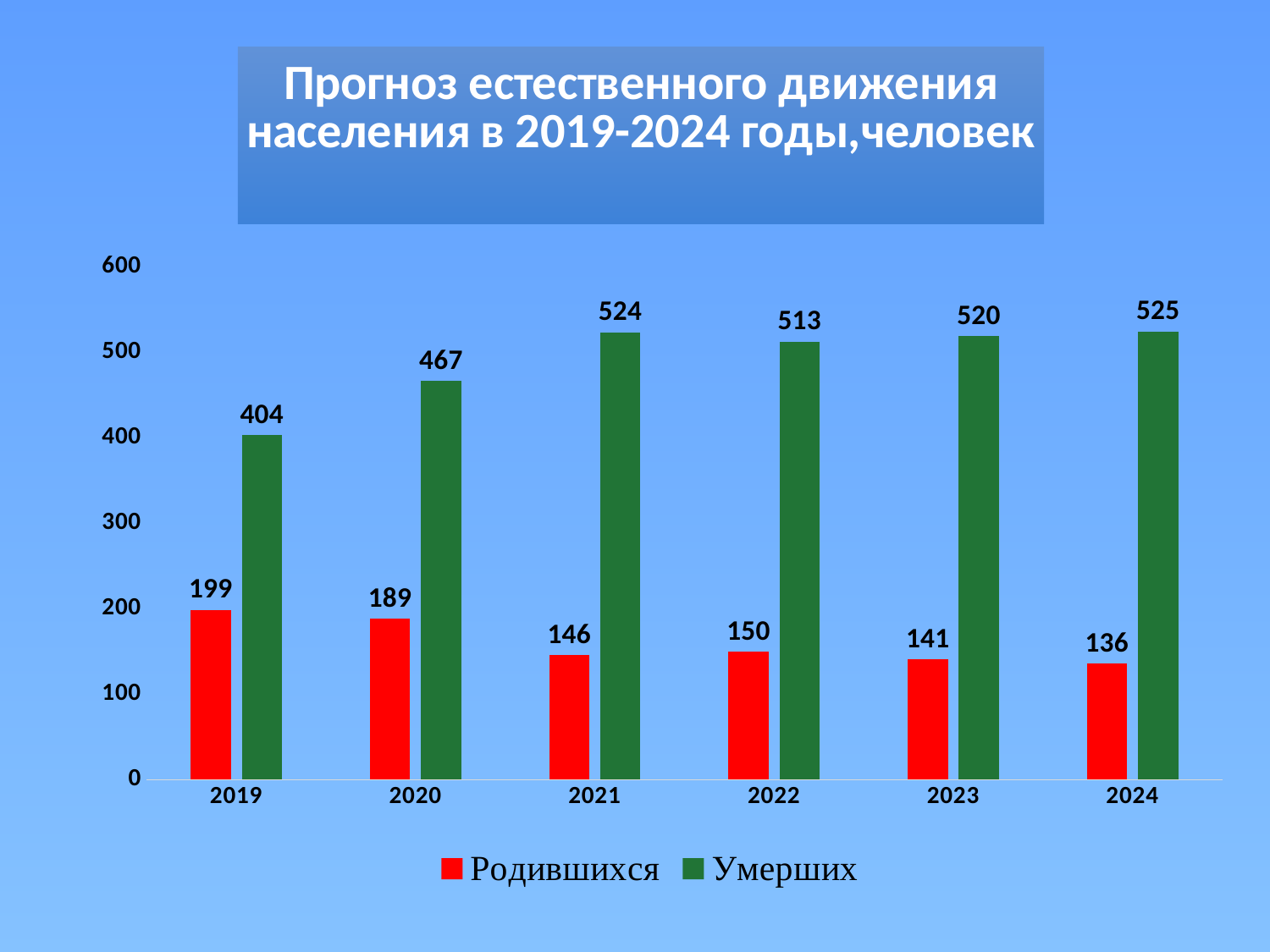
What is the value for Родившихся in 2019? 199 What kind of chart is shown on the slide? Bar chart In which year is the value for Родившихся lowest? 2024 Which is larger in 2020: Родившихся or Умерших? Умерших How many series does the legend list? 2 What is the difference between Умерших and Родившихся in 2021? 378 How many years are shown on the x axis? 6 In which year is the value for Умерших highest? 2024 What is the value for Родившихся in 2024? 136 Does the value for Родившихся generally rise or fall from 2019 to 2024? Fall What is the value for Умерших in 2022? 513 What colour are the bars for Умерших? Green